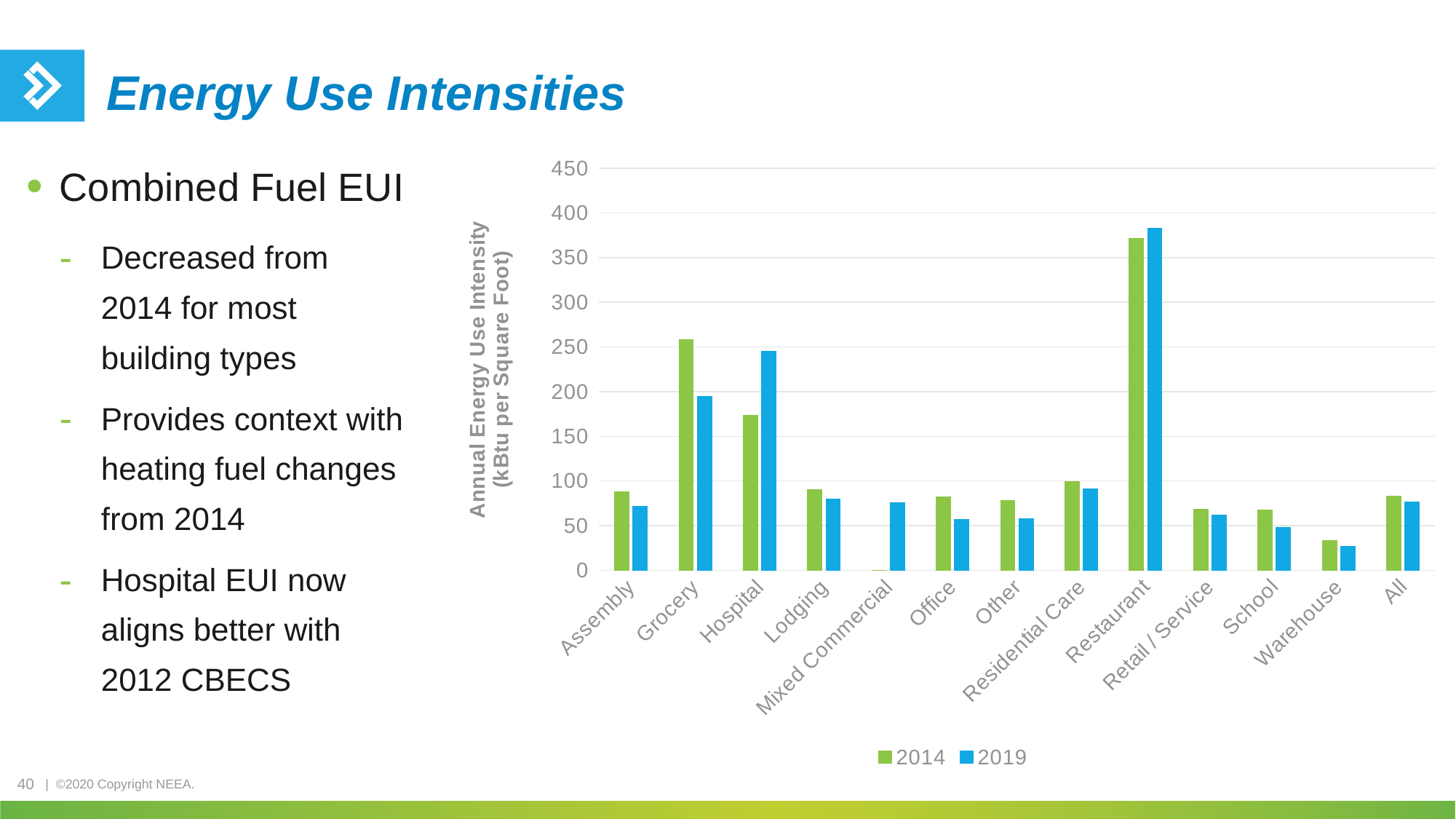
How many building-type categories are shown on the x axis? 13 Is the 2014 value for Grocery greater or less than 200? greater What kind of chart is shown on the slide? Bar chart Which category has the lowest 2019 energy use intensity? Warehouse For Hospital, which is larger: the 2014 value or the 2019 value? 2019 How many series does the legend list? 2 For Grocery, which is larger: the 2014 value or the 2019 value? 2014 Is the 2019 value for Warehouse greater or less than 50? less What is the title of the y axis? Annual Energy Use Intensity (kBtu per Square Foot) Which category has the highest 2014 energy use intensity? Restaurant Which category has the highest 2019 energy use intensity? Restaurant Is the 2019 value for Restaurant greater or less than 350? greater